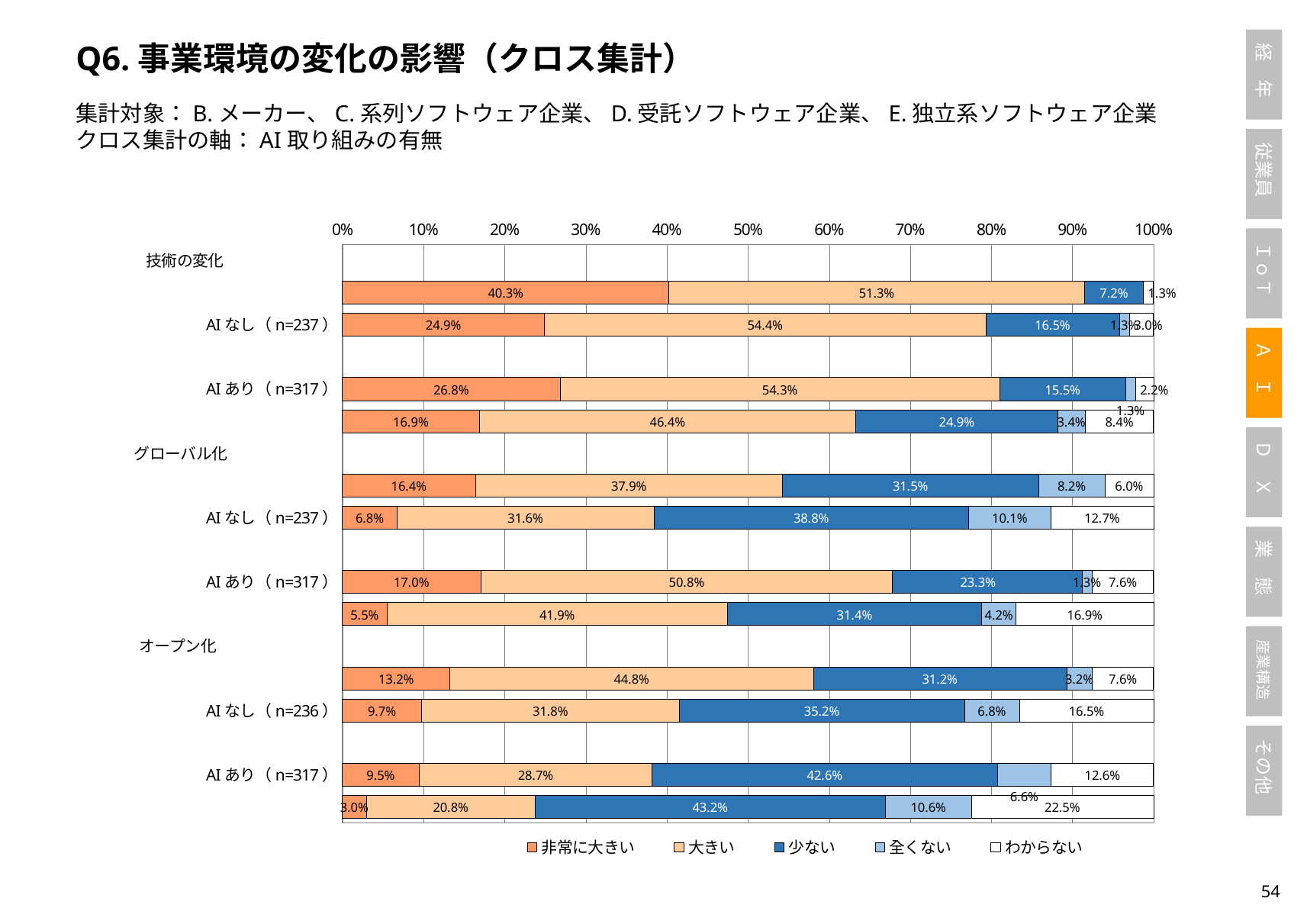
In the topmost bar of the chart, what is the value for 大きい? 51.3% In the topmost bar of the chart, what is the value for 非常に大きい? 40.3% In the topmost bar, what is the difference between the 大きい value (51.3%) and the 非常に大きい value (40.3%)? 11.0% What are the legend entries of the chart, from left to right? 非常に大きい, 大きい, 少ない, 全くない, わからない In the bottommost bar of the chart, what is the value for わからない? 22.5% What kind of chart is shown on the slide? Stacked horizontal bar chart In the topmost bar, which is larger: the 非常に大きい segment or the 大きい segment? 大きい Which bar has the largest 非常に大きい segment, and what is its value? The topmost bar, 40.3% In the bottommost bar of the chart, what is the value for 少ない? 43.2% How many stacked bars are plotted in the chart? 12 What is the maximum value shown on the horizontal axis? 100% How many series does the legend list? 5